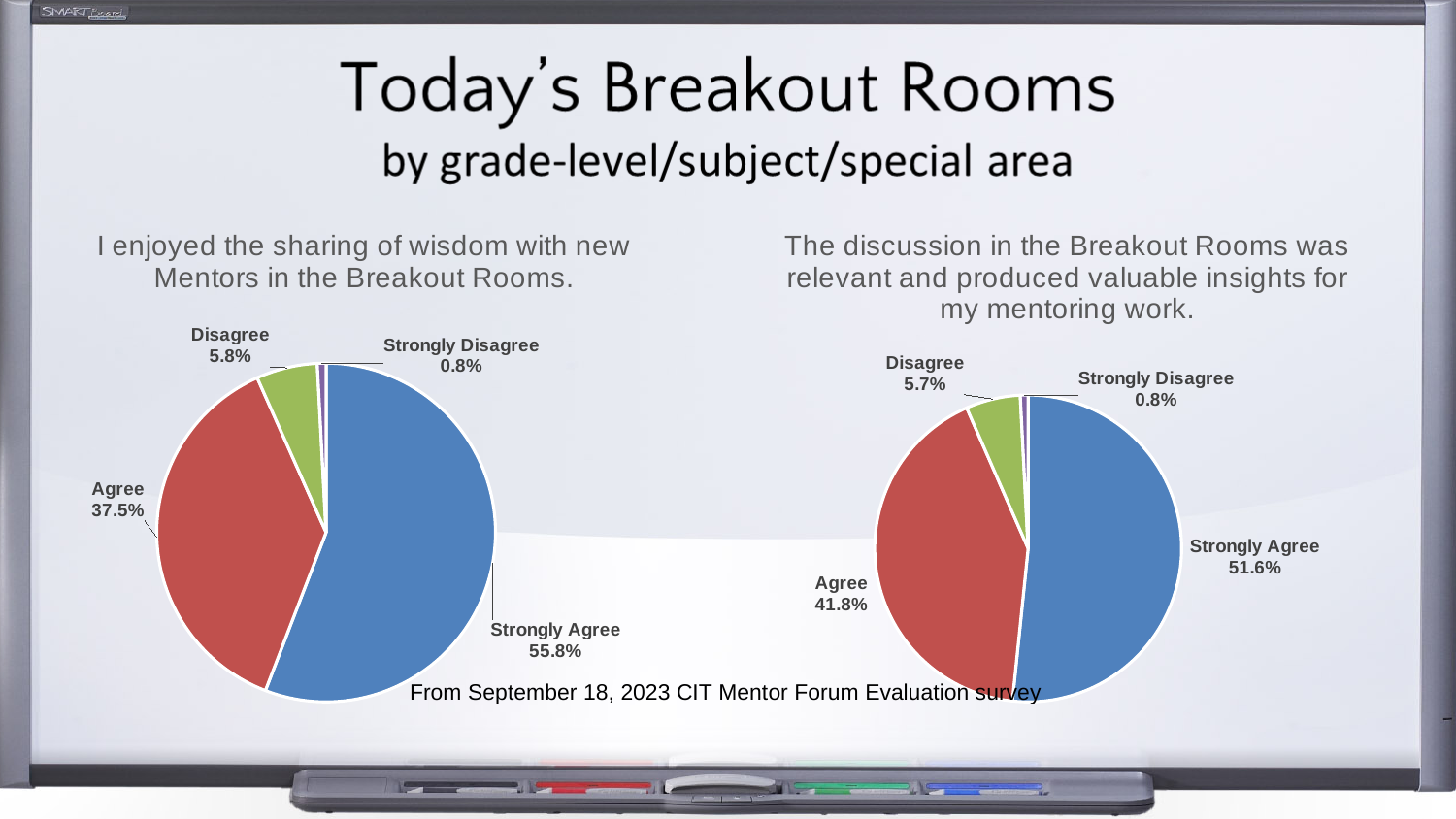
In the right pie chart ("The discussion in the Breakout Rooms was relevant and produced valuable insights for my mentoring work."), what share of responses is Strongly Agree? 51.6% In the right pie chart ("The discussion in the Breakout Rooms was relevant and produced valuable insights for my mentoring work."), what is the difference between the Agree and Disagree shares? 36.1% In the left pie chart ("I enjoyed the sharing of wisdom with new Mentors in the Breakout Rooms."), which category has the smallest share? Strongly Disagree In the left pie chart ("I enjoyed the sharing of wisdom with new Mentors in the Breakout Rooms."), what percentage of responses is Agree? 37.5% In the right pie chart ("The discussion in the Breakout Rooms was relevant and produced valuable insights for my mentoring work."), what percentage of responses is Disagree? 5.7% In the left pie chart ("I enjoyed the sharing of wisdom with new Mentors in the Breakout Rooms."), what colour is the Agree slice? Red In the right pie chart ("The discussion in the Breakout Rooms was relevant and produced valuable insights for my mentoring work."), which category has the largest share? Strongly Agree What kind of chart is used on the right side of the slide for the statement about the discussion in the Breakout Rooms? Pie chart In the left pie chart ("I enjoyed the sharing of wisdom with new Mentors in the Breakout Rooms."), what share of responses is Strongly Agree? 55.8% In the right pie chart ("The discussion in the Breakout Rooms was relevant and produced valuable insights for my mentoring work."), which is larger: Agree or Disagree? Agree How many categories does the left pie chart ("I enjoyed the sharing of wisdom with new Mentors in the Breakout Rooms.") show? 4 In the left pie chart ("I enjoyed the sharing of wisdom with new Mentors in the Breakout Rooms."), what is the difference between the Strongly Agree and Agree shares? 18.3%